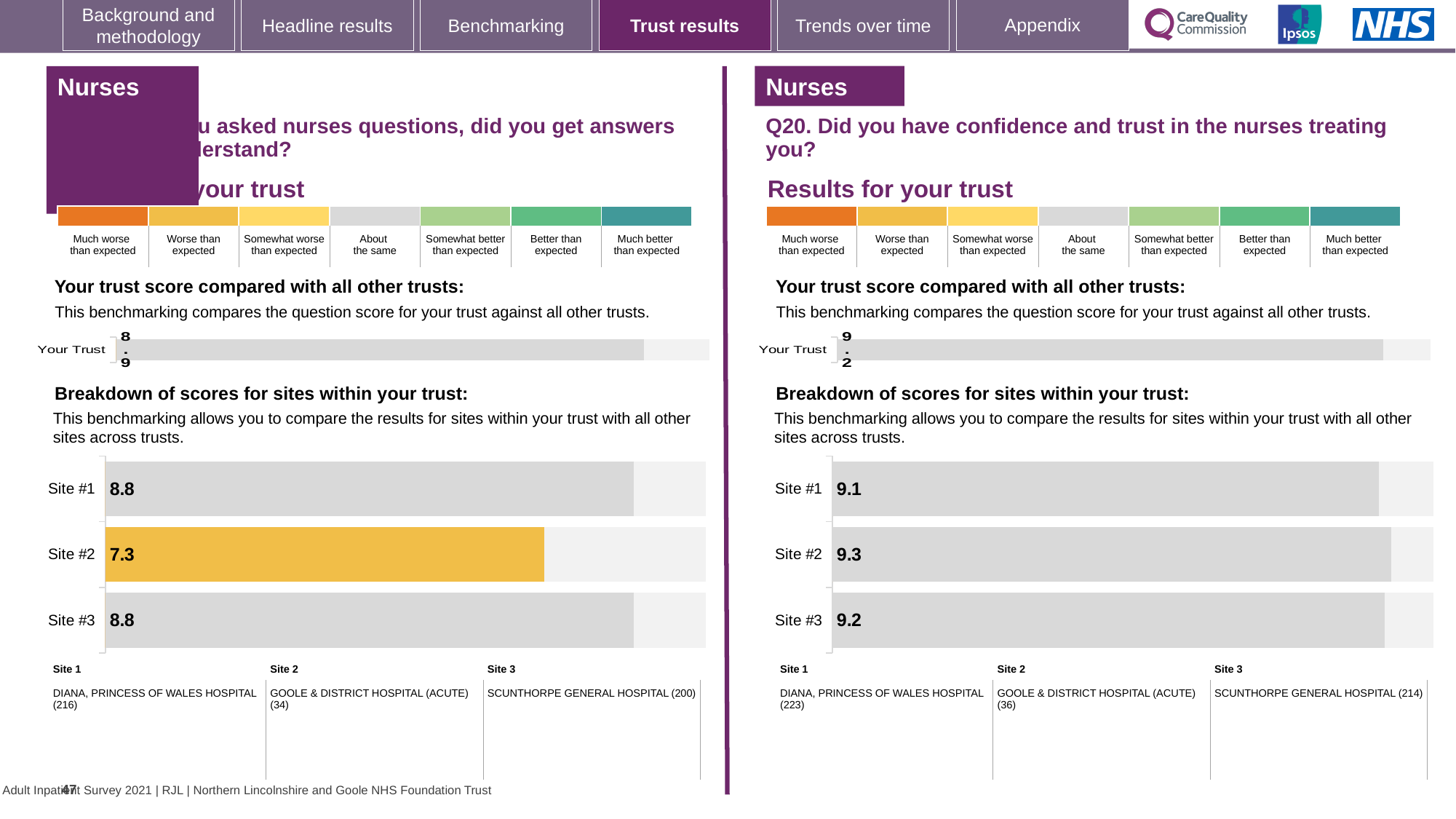
On the left-hand site breakdown chart, which site has the lowest score? Site #2 On the left-hand site breakdown chart, what is the score for Site #2? 7.3 On the right-hand (Q20) site breakdown chart, which is larger: the score for Site #3 or the score for Site #1? Site #3 On the right-hand (Q20) site breakdown chart, what is the difference between the scores for Site #2 and Site #1? 0.2 On the left-hand site breakdown chart, what is the score for Site #1? 8.8 On the right-hand (Q20) site breakdown chart, which site has the highest score? Site #2 On the left-hand 'Your trust score compared with all other trusts' chart, what is the value for Your Trust? 8.9 How many sites are shown on the left-hand site breakdown chart? 3 What type of chart is used for the site breakdown on the right-hand (Q20) side of the slide? Bar chart On the left-hand site breakdown chart, what is the difference between the scores for Site #1 and Site #2? 1.5 On the right-hand (Q20) site breakdown chart, what is the score for Site #2? 9.3 On the right-hand (Q20) 'Your trust score compared with all other trusts' chart, what is the value for Your Trust? 9.2